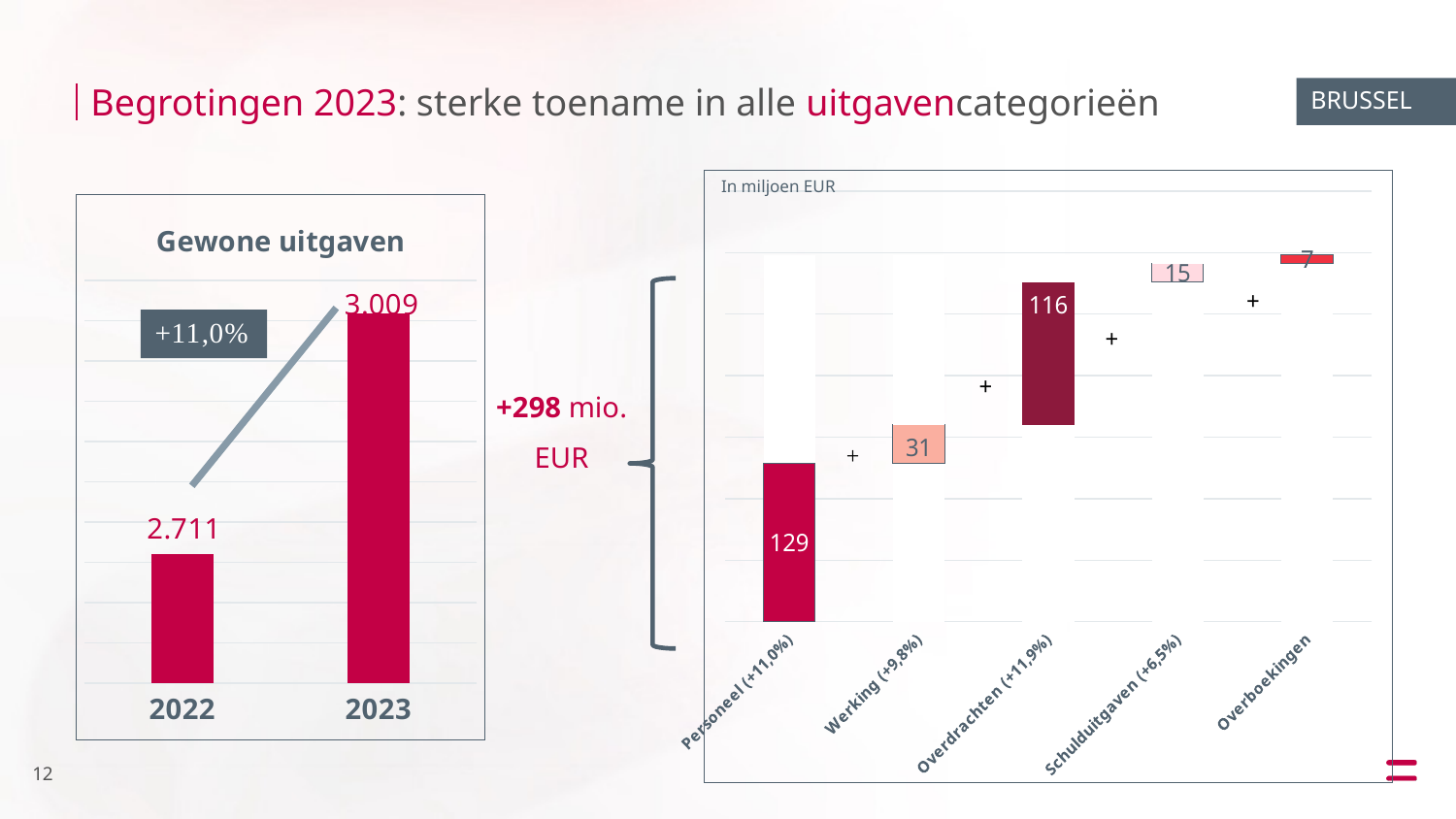
In the right-hand chart (In miljoen EUR), what is the value for Personeel? 129 In the 'Gewone uitgaven' chart, what is the value for 2023? 3.009 In the right-hand chart (In miljoen EUR), what is the value for Overdrachten? 116 In the right-hand chart (In miljoen EUR), what is the value for Werking? 31 In the 'Gewone uitgaven' chart, what percentage change is shown between 2022 and 2023? +11,0% In the 'Gewone uitgaven' chart, how many years are plotted? 2 In the 'Gewone uitgaven' chart, what is the value for 2022? 2.711 In the right-hand chart (In miljoen EUR), how many categories are shown on the x axis? 5 In the 'Gewone uitgaven' chart, what is the difference between the 2023 and 2022 values? 298 In the 'Gewone uitgaven' chart, which year has the higher value? 2023 In the right-hand chart (In miljoen EUR), which category has the lowest value? Overboekingen In the right-hand chart (In miljoen EUR), which category has the highest value? Personeel